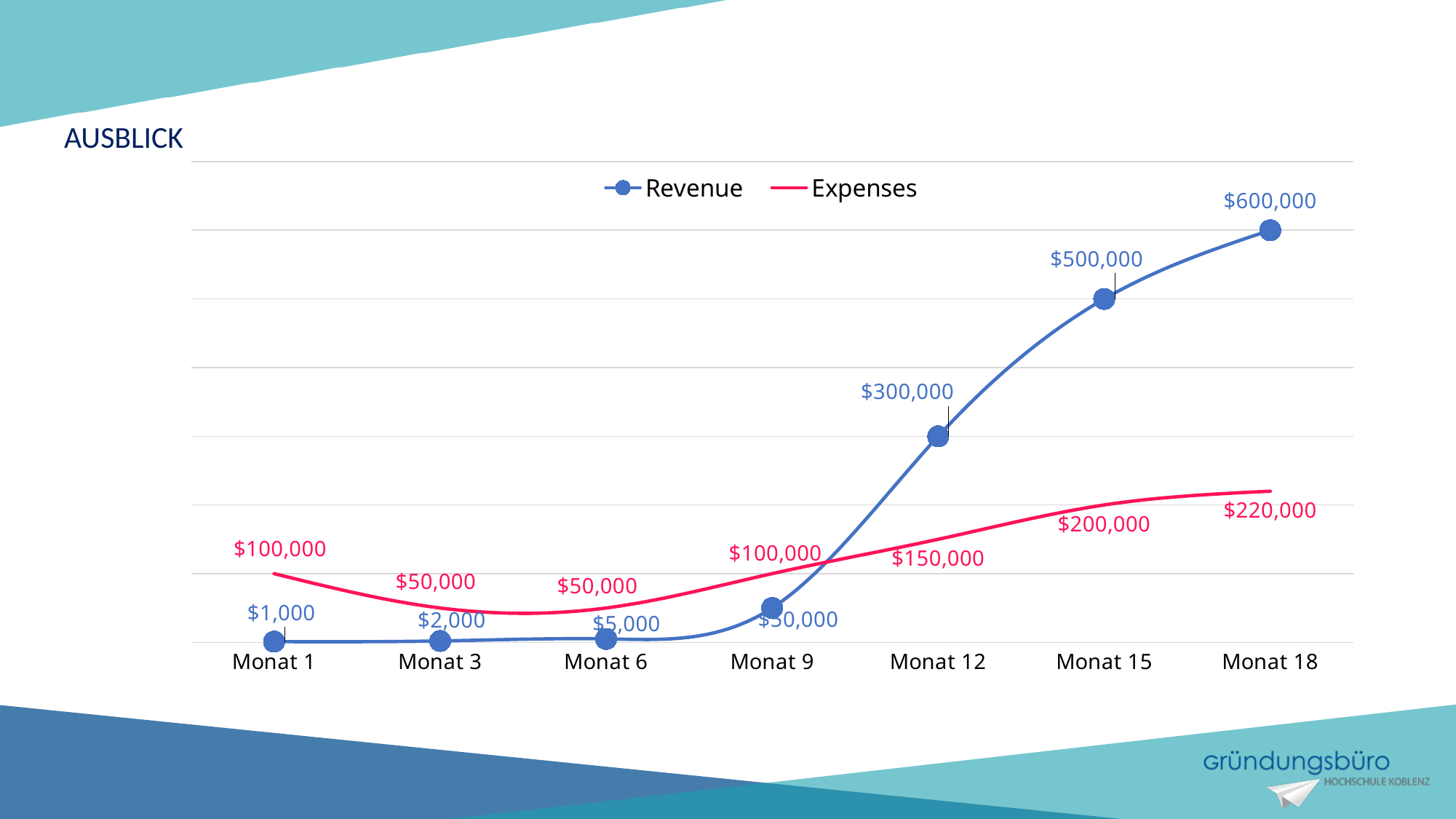
How many months (categories) are plotted on the x axis? 7 What is the Revenue value at Monat 12? $300,000 How many series does the legend list? 2 Which series is drawn in red? Expenses What is the difference between Revenue and Expenses at Monat 18? $380,000 What is the Expenses value at Monat 15? $200,000 At Monat 9, which is larger, Revenue or Expenses? Expenses What type of chart is shown on the slide? Line chart What is the Revenue value at Monat 1? $1,000 Does Revenue rise or fall from Monat 1 to Monat 18? Rise At which month is Revenue highest? Monat 18 At which month is Revenue lowest? Monat 1